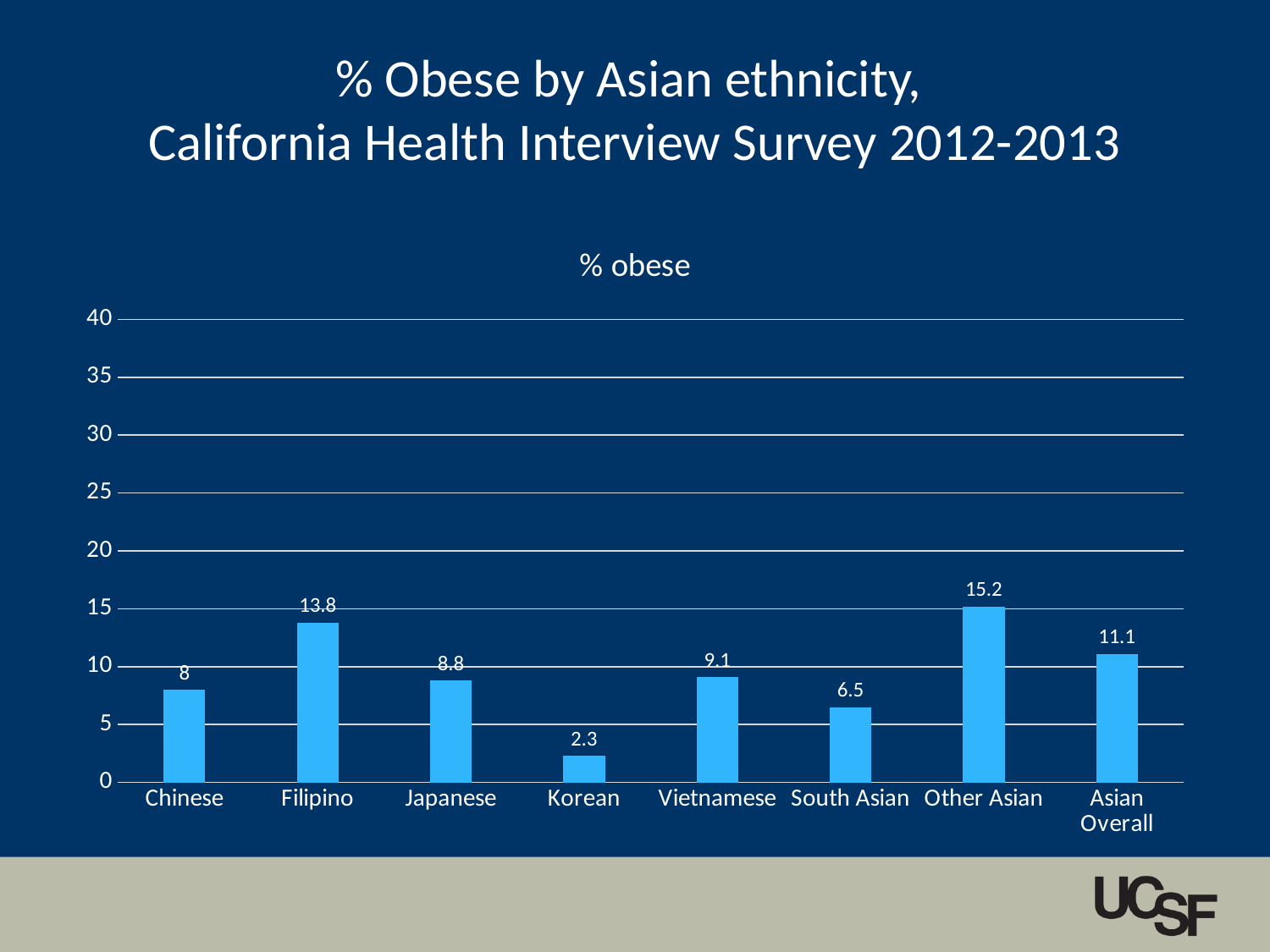
What is the % obese value for Filipino? 13.8 Is the value for Japanese greater or less than 10? less Which ethnicity has the highest % obese? Other Asian What kind of chart is shown on the slide? bar chart Which has a higher % obese, Vietnamese or South Asian? Vietnamese What is the % obese value for Korean? 2.3 What is the highest value shown on the y axis? 40 How many ethnicity categories are shown on the x axis? 8 Which ethnicity has the lowest % obese? Korean What is the % obese value for Asian Overall? 11.1 What is the difference in % obese between Other Asian and Chinese? 7.2 What is the title of the chart? % obese